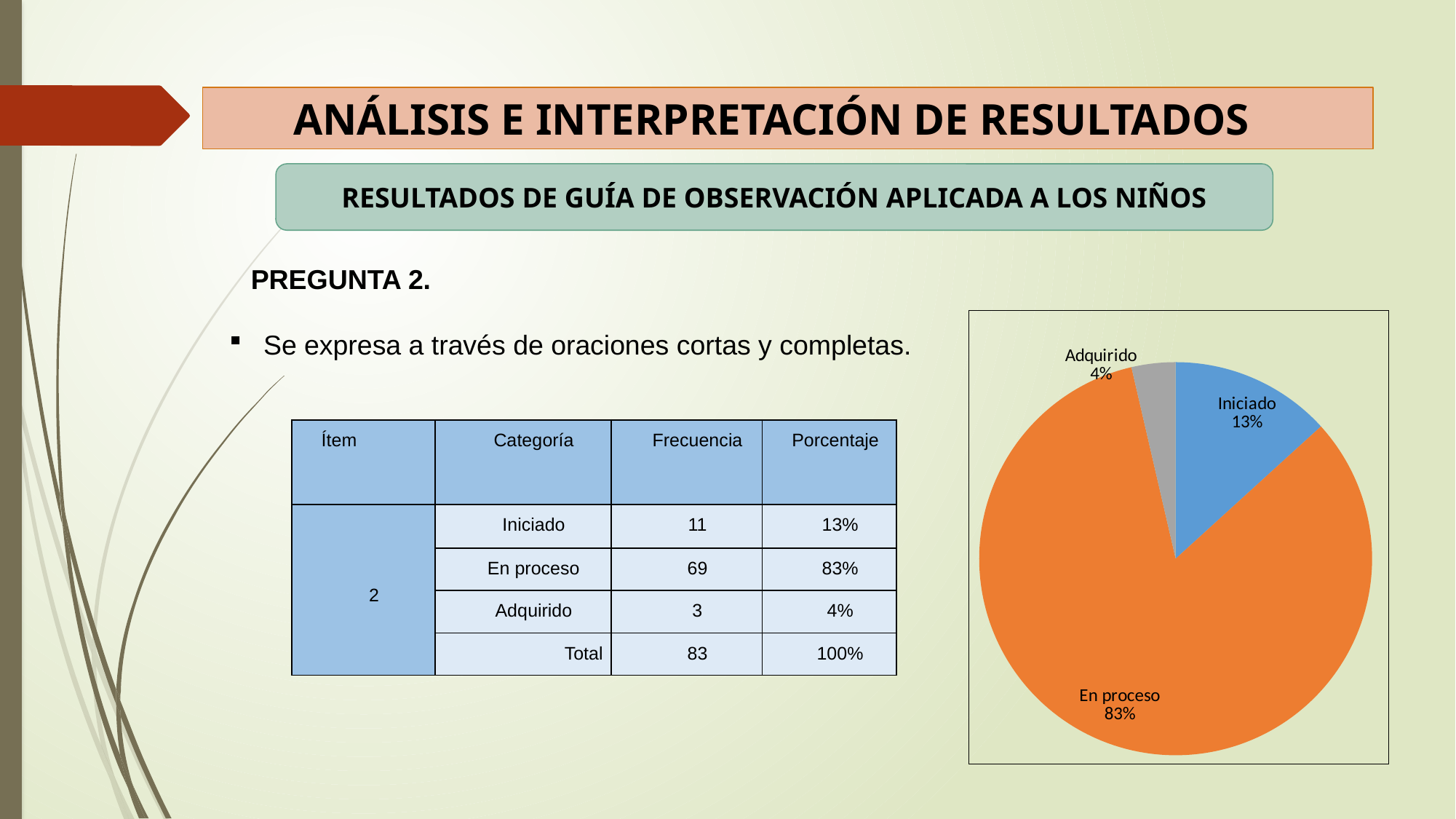
How many slices does the pie chart have? 3 Which slice is larger in the pie chart, Iniciado or Adquirido? Iniciado What share of the pie chart does Adquirido represent? 4% What colour is the Iniciado slice in the pie chart? blue What colour is the En proceso slice in the pie chart? orange What share of the pie chart does Iniciado represent? 13% Which category has the smallest slice in the pie chart? Adquirido What is the difference in percentage points between the En proceso slice and the Iniciado slice? 70% What share of the pie chart does En proceso represent? 83% What kind of chart is shown on the slide? pie chart Which category has the largest slice in the pie chart? En proceso What is the difference in percentage points between the Iniciado slice and the Adquirido slice? 9%